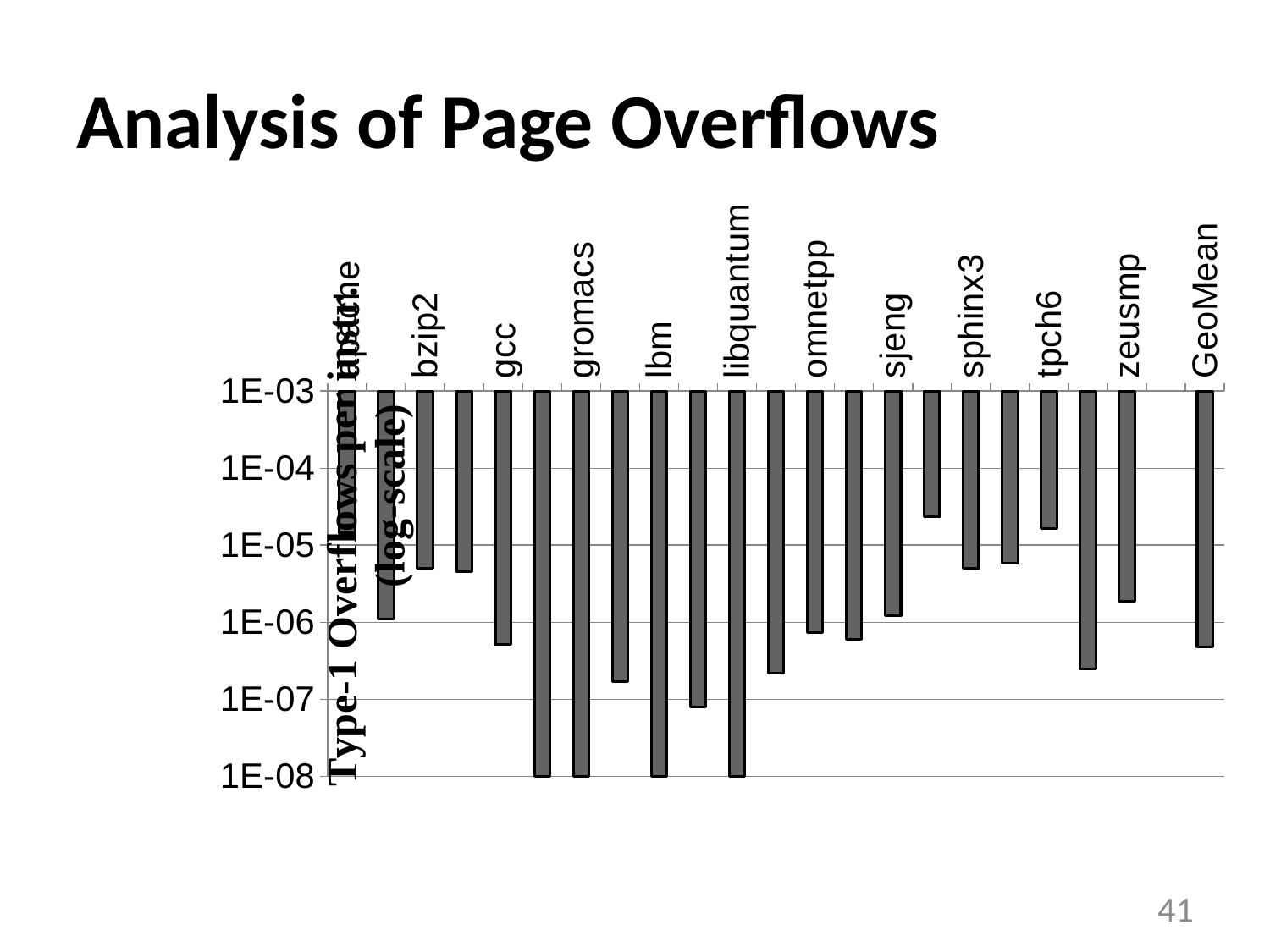
Is the value for gcc greater or less than 1E-06? less What is the label of the vertical axis of the chart? Type-1 Overflows per instr. (log scale) What kind of chart is shown on the slide? bar chart Which has the larger value, tpch6 or gcc? tpch6 Is the value for libquantum greater or less than 1E-06? less What is the lowest tick value shown on the vertical axis? 1E-08 Is the value for GeoMean greater or less than 1E-06? less Which has the larger value, bzip2 or gromacs? bzip2